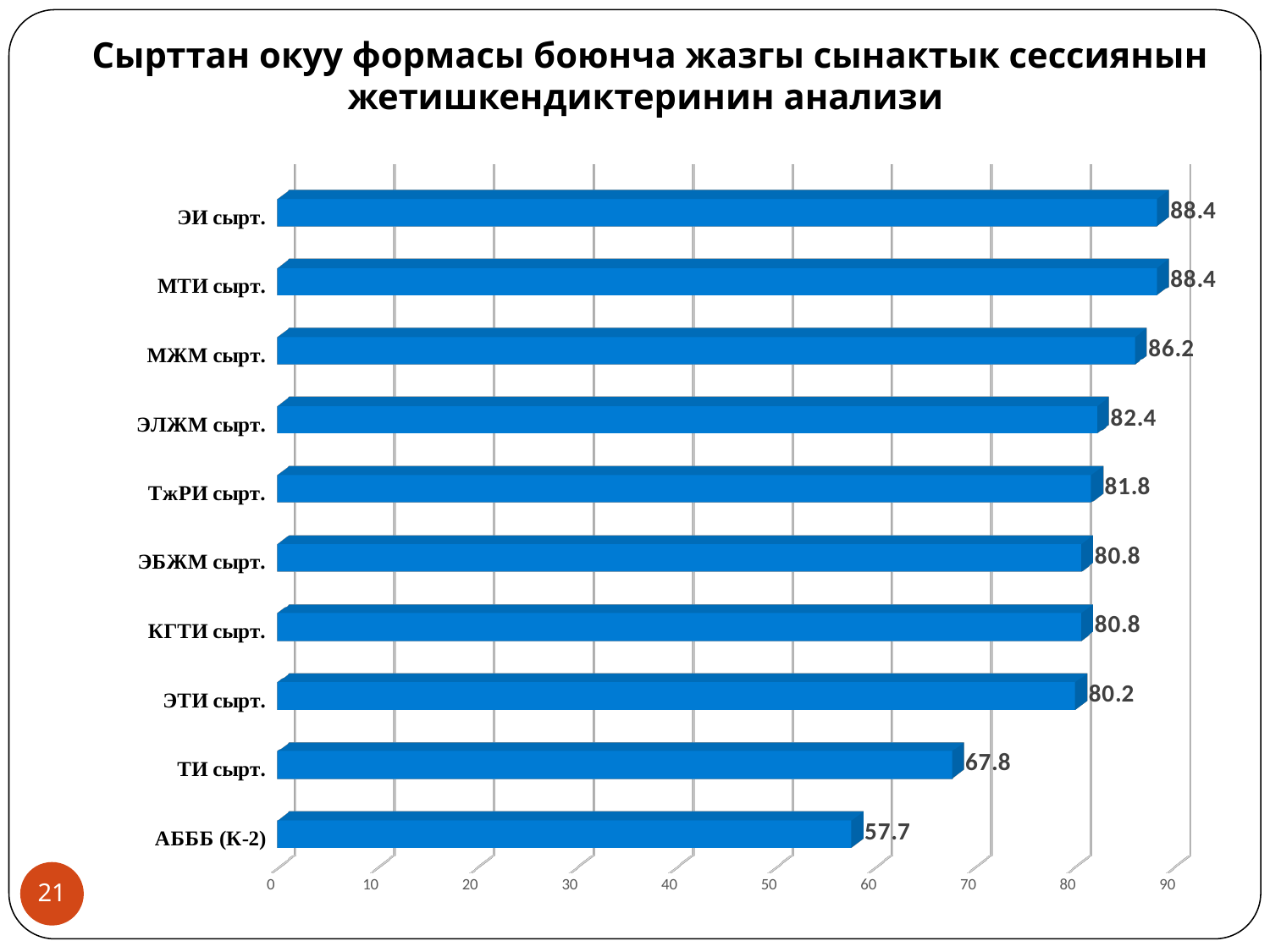
Is the value for ТИ сырт. greater or less than 70? less Which is larger, the value for МЖМ сырт. or the value for ЭТИ сырт.? МЖМ сырт. What is the value for МЖМ сырт.? 86.2 How many categories are shown in the chart? 10 What kind of chart is shown on the slide? bar chart What is the value for ЭЛЖМ сырт.? 82.4 What is the value for ТИ сырт.? 67.8 What is the value for АБББ (К-2)? 57.7 What is the difference between the values for ТжРИ сырт. and ТИ сырт.? 14 What is the value for КГТИ сырт.? 80.8 Which category has the lowest value? АБББ (К-2) What is the difference between the values for ЭИ сырт. and АБББ (К-2)? 30.7